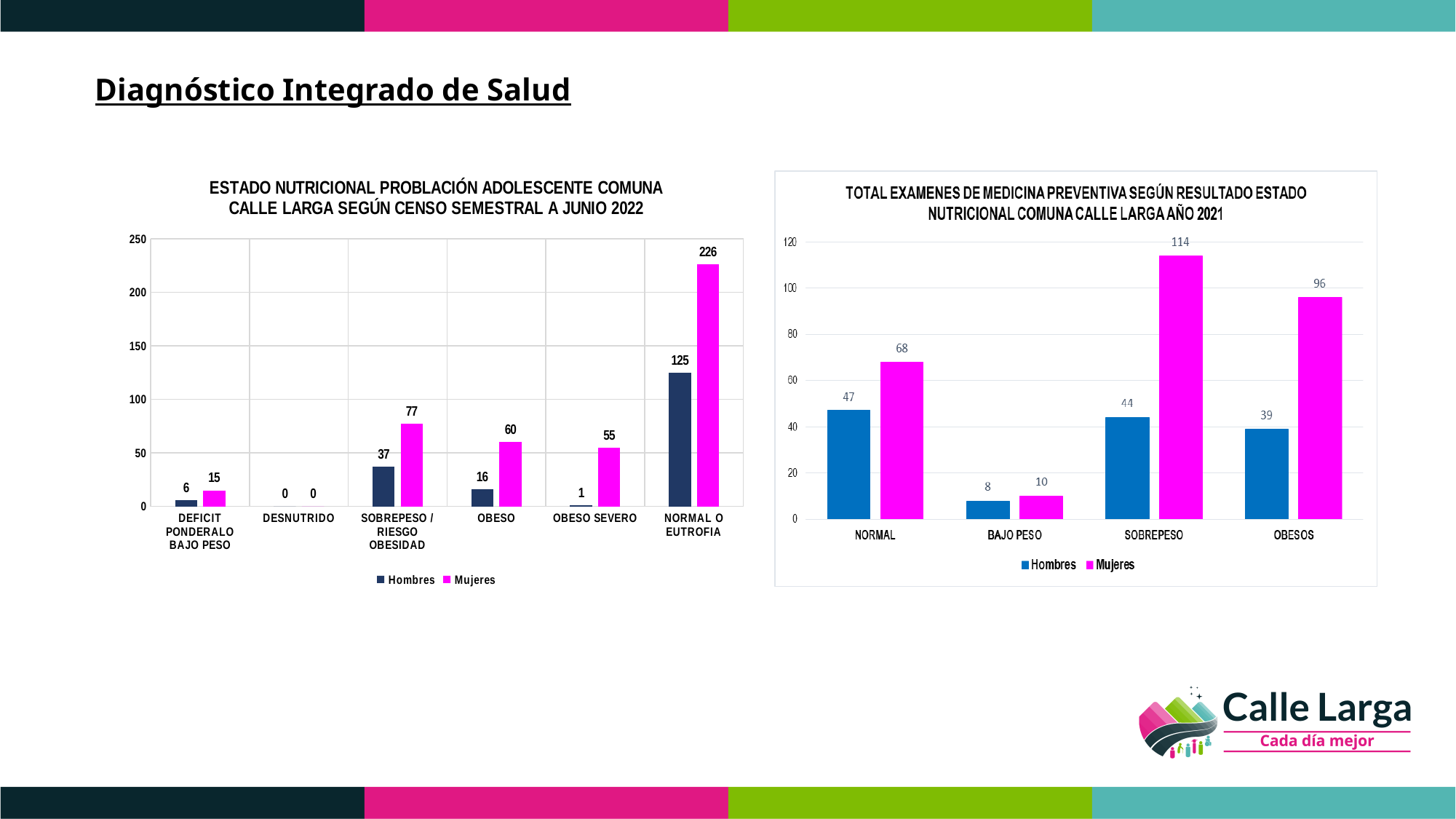
In the right chart (Total Exámenes de Medicina Preventiva), what is the value for Mujeres in the SOBREPESO category? 114 In the left chart (Estado Nutricional Población Adolescente), how many categories are shown on the x axis? 6 What kind of chart is the right chart (Total Exámenes de Medicina Preventiva)? Bar chart In the left chart (Estado Nutricional Población Adolescente), what is the value for Hombres in the OBESO SEVERO category? 1 In the left chart (Estado Nutricional Población Adolescente), what is the value for Mujeres in the NORMAL O EUTROFIA category? 226 In the right chart (Total Exámenes de Medicina Preventiva), what is the difference between Mujeres and Hombres in the OBESOS category? 57 In the right chart (Total Exámenes de Medicina Preventiva), which is larger: Hombres in NORMAL or Hombres in SOBREPESO? Hombres in NORMAL In the left chart (Estado Nutricional Población Adolescente), which category has the highest value for Hombres? NORMAL O EUTROFIA In the right chart (Total Exámenes de Medicina Preventiva), which category has the lowest value for Hombres? BAJO PESO How many series does the legend of the right chart (Total Exámenes de Medicina Preventiva) list? 2 In the left chart (Estado Nutricional Población Adolescente), what is the difference between Mujeres and Hombres in the OBESO category? 44 In the left chart (Estado Nutricional Población Adolescente), what is the value for Hombres in the SOBREPESO / RIESGO OBESIDAD category? 37